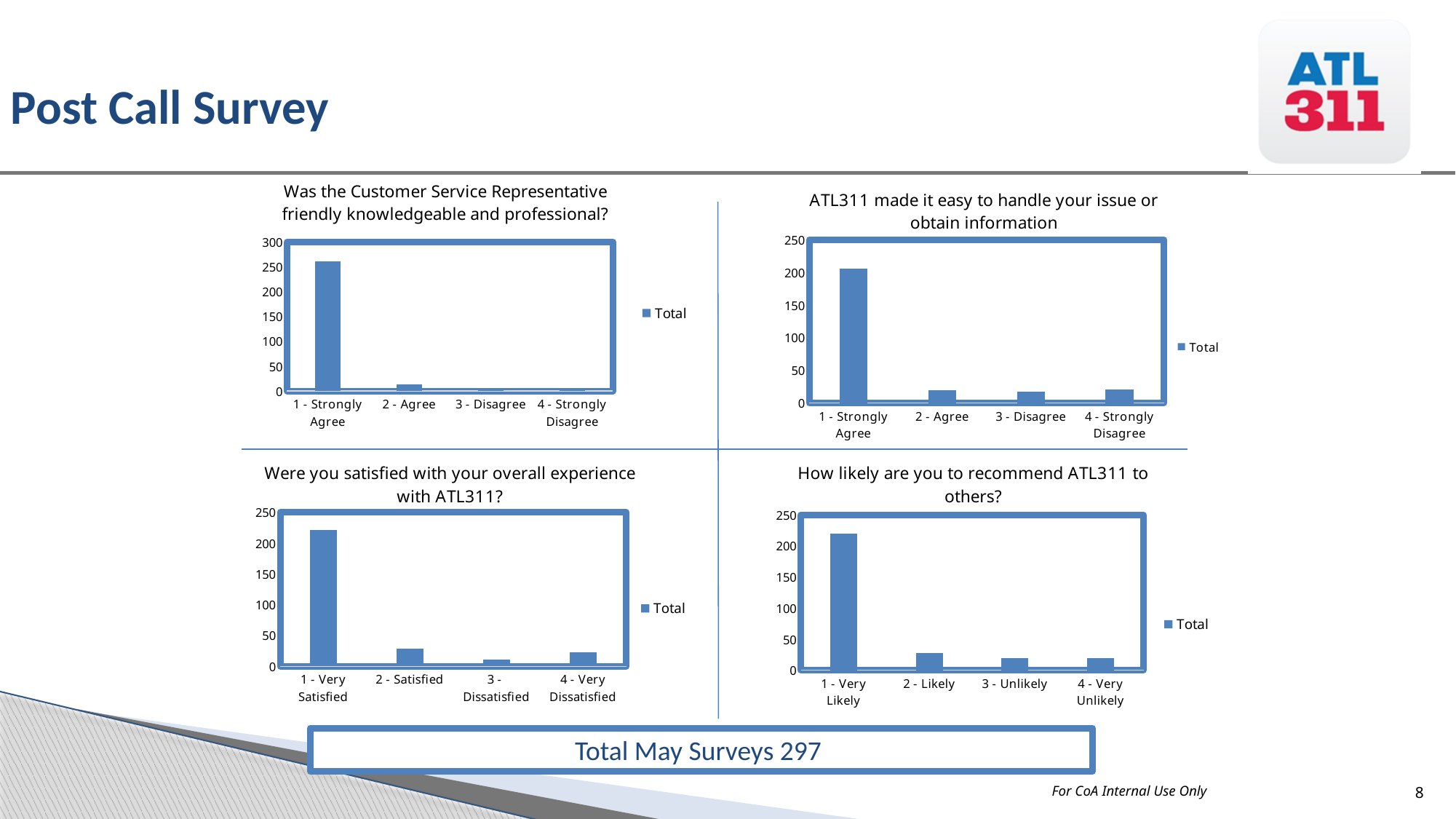
In the chart titled "How likely are you to recommend ATL311 to others?", is the value for 1 - Very Likely greater or less than 150? greater In the chart titled "Was the Customer Service Representative friendly knowledgeable and professional?", which category has the highest value? 1 - Strongly Agree In the chart titled "Was the Customer Service Representative friendly knowledgeable and professional?", is the value for 1 - Strongly Agree greater or less than 200? greater In the chart titled "ATL311 made it easy to handle your issue or obtain information", which category has the highest value? 1 - Strongly Agree In the chart titled "Were you satisfied with your overall experience with ATL311?", how many series does the legend list? 1 How many charts are shown on the slide? 4 What kind of chart is the chart titled "ATL311 made it easy to handle your issue or obtain information"? bar chart In the chart titled "How likely are you to recommend ATL311 to others?", which category has the highest value? 1 - Very Likely In the chart titled "Were you satisfied with your overall experience with ATL311?", which category has the lowest value? 3 - Dissatisfied In the chart titled "ATL311 made it easy to handle your issue or obtain information", is the value for 2 - Agree greater or less than 50? less In the chart titled "Were you satisfied with your overall experience with ATL311?", which is larger, 2 - Satisfied or 3 - Dissatisfied? 2 - Satisfied In the chart titled "How likely are you to recommend ATL311 to others?", how many categories are shown on the x axis? 4